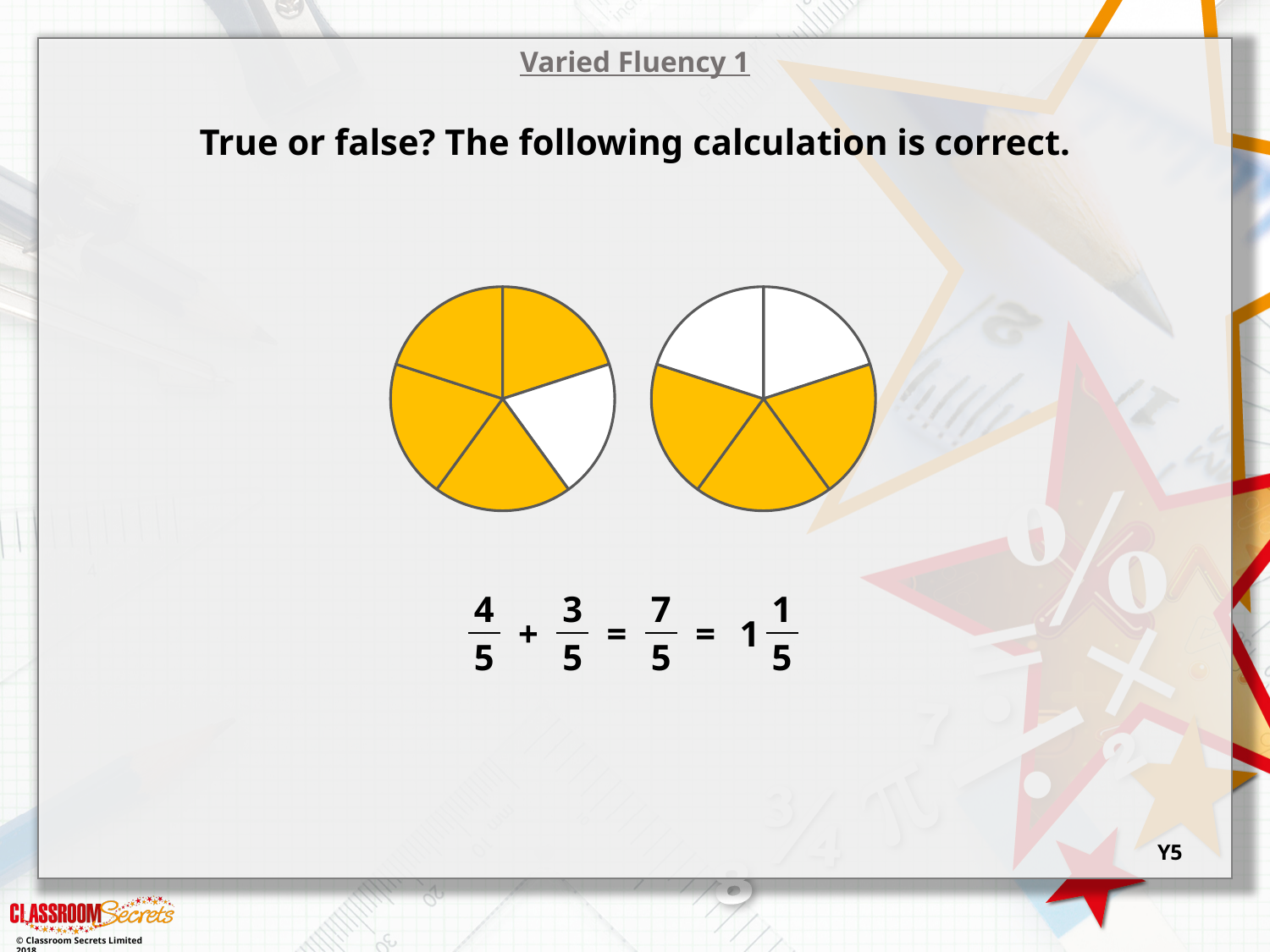
Which circle has more shaded sections, the left or the right? left How many equal sections is the right circle divided into? 5 What colour are the shaded sections of the circles? yellow What is the title at the top of the slide? Varied Fluency 1 How many circle diagrams are shown on the slide? 2 How many sections of the left circle are shaded yellow? 4 How many more sections are shaded in the left circle than in the right circle? 1 What fraction of the right circle is shaded, as written on the slide? 3/5 What fraction of the left circle is shaded, as written on the slide? 4/5